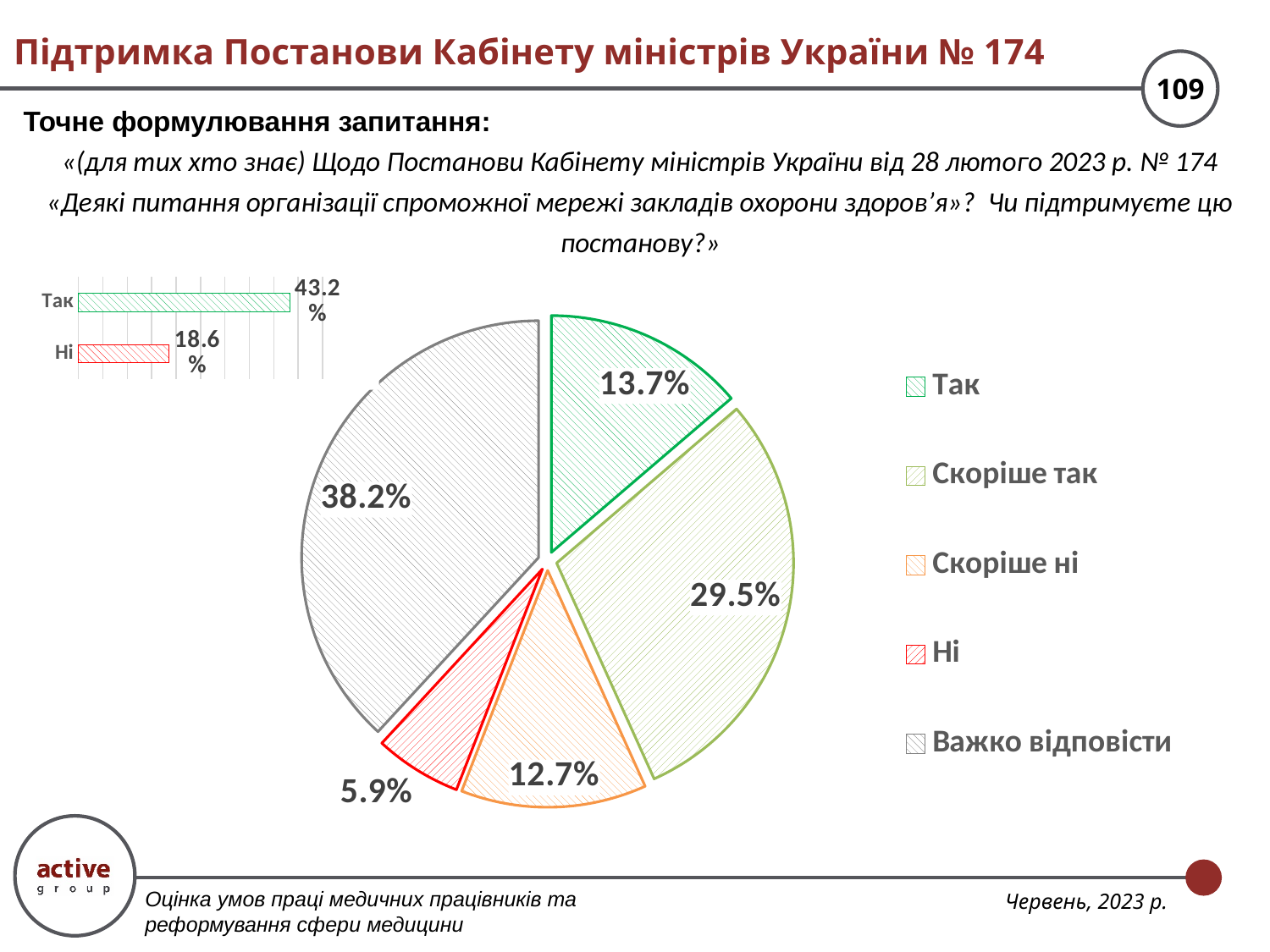
In the pie chart, which is larger: the share for «Так» or the share for «Скоріше ні»? Так In the pie chart, which answer category has the largest share? Важко відповісти In the pie chart, what is the difference between the shares for «Скоріше так» and «Скоріше ні»? 16.8% How many slices does the pie chart have? 5 In the pie chart, what share of respondents answered «Так»? 13.7% In the small bar chart at the top left, what is the value for «Так»? 43.2% In the small bar chart at the top left, what is the value for «Ні»? 18.6% In the pie chart, what share of respondents answered «Важко відповісти»? 38.2% In the pie chart, what share of respondents answered «Скоріше так»? 29.5% What kind of chart is the small chart at the top left of the slide? Bar chart How many entries does the legend of the pie chart list? 5 In the pie chart, which answer category has the smallest share? Ні